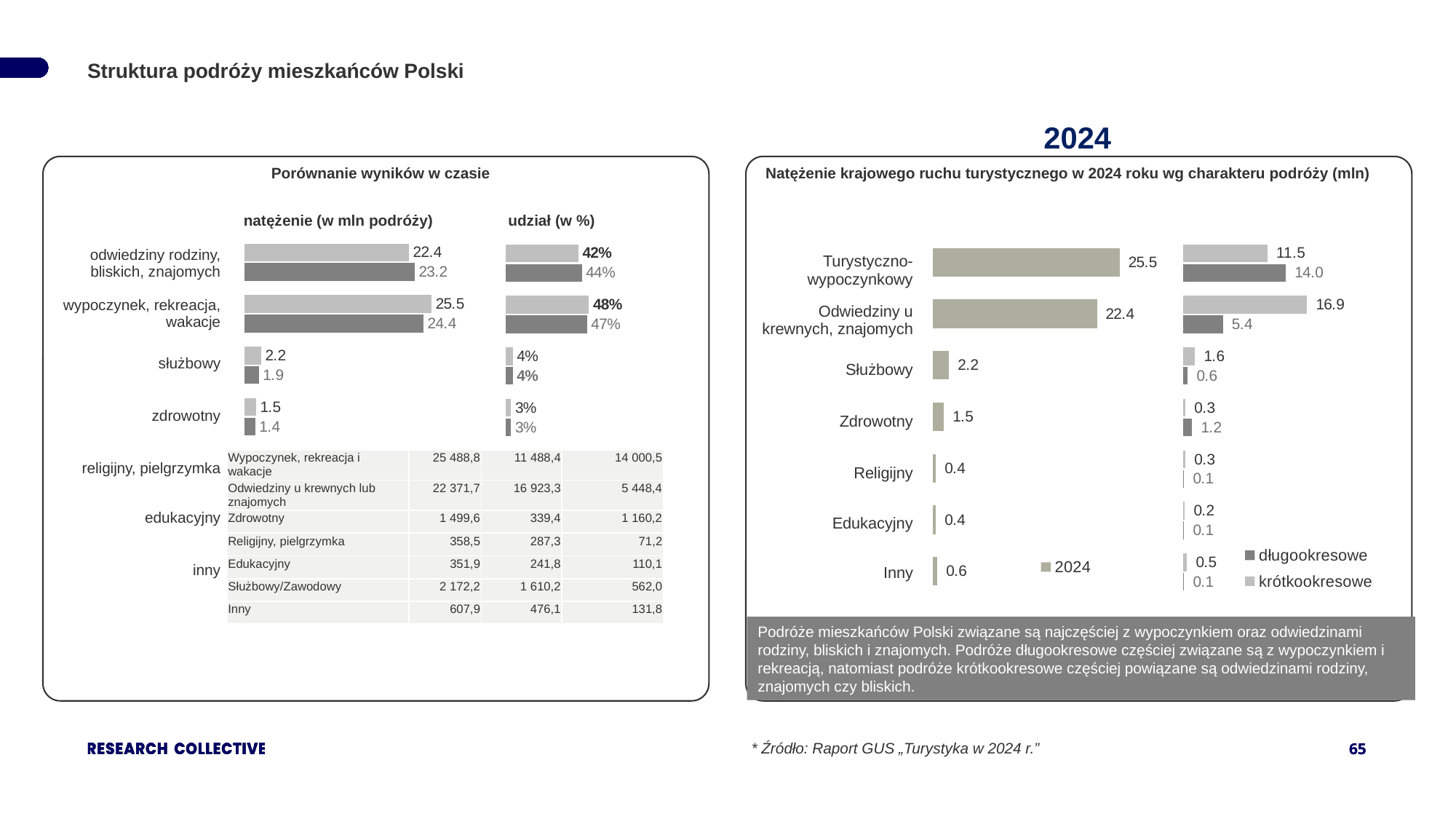
On the chart 'Natężenie krajowego ruchu turystycznego w 2024 roku wg charakteru podróży (mln)', what is the krótkookresowe value for Odwiedziny u krewnych, znajomych? 16.9 On the chart 'Natężenie krajowego ruchu turystycznego w 2024 roku wg charakteru podróży (mln)', what is the difference between the krótkookresowe and długookresowe values for Odwiedziny u krewnych, znajomych? 11.5 On the chart 'Porównanie wyników w czasie', what is the natężenie (w mln podróży) value shown on the dark grey bar for odwiedziny rodziny, bliskich, znajomych? 23.2 How many categories are shown on the chart 'Natężenie krajowego ruchu turystycznego w 2024 roku wg charakteru podróży (mln)'? 7 On the chart 'Natężenie krajowego ruchu turystycznego w 2024 roku wg charakteru podróży (mln)', which category has the lowest krótkookresowe value? Edukacyjny On the chart 'Porównanie wyników w czasie', what is the udział (w %) value shown on the light grey bar for wypoczynek, rekreacja, wakacje? 48% On the chart 'Natężenie krajowego ruchu turystycznego w 2024 roku wg charakteru podróży (mln)', what is the total value for Turystyczno-wypoczynkowy? 25.5 What kind of chart is 'Natężenie krajowego ruchu turystycznego w 2024 roku wg charakteru podróży (mln)'? bar chart On the chart 'Natężenie krajowego ruchu turystycznego w 2024 roku wg charakteru podróży (mln)', which category has the highest total 2024 value? Turystyczno-wypoczynkowy How many series does the legend list on the chart 'Natężenie krajowego ruchu turystycznego w 2024 roku wg charakteru podróży (mln)'? 3 On the chart 'Natężenie krajowego ruchu turystycznego w 2024 roku wg charakteru podróży (mln)', what is the długookresowe value for Zdrowotny? 1.2 On the chart 'Natężenie krajowego ruchu turystycznego w 2024 roku wg charakteru podróży (mln)', which is larger for Turystyczno-wypoczynkowy: długookresowe or krótkookresowe? długookresowe